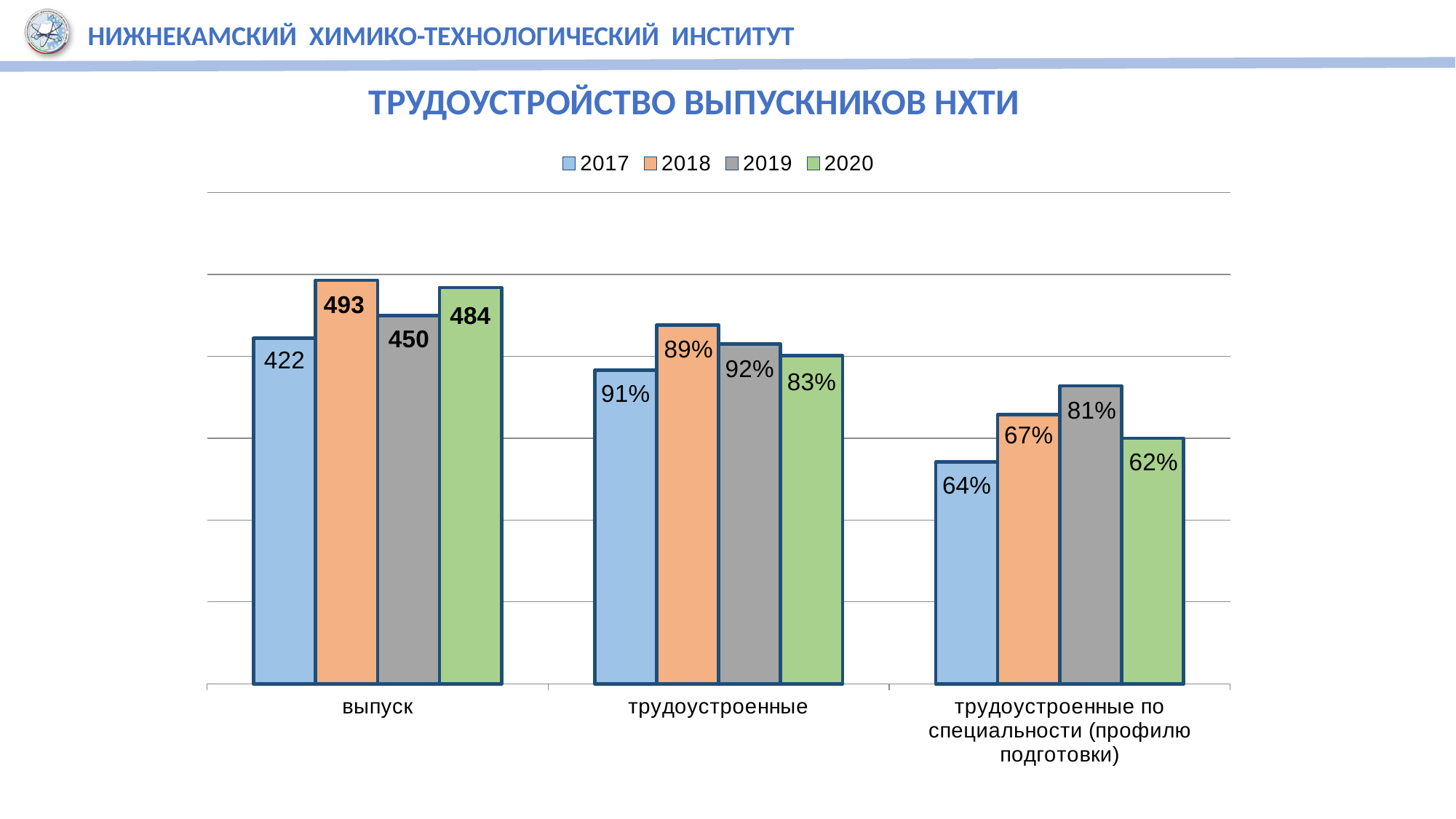
What kind of chart is shown on the slide? bar chart Which year has the lowest value in the 'выпуск' category? 2017 What is the value for 2017 in the 'трудоустроенные' category? 91% What is the difference between the 2018 and 2017 values in the 'выпуск' category? 71 What is the value for 2018 in the 'выпуск' category? 493 How many categories are shown on the x axis? 3 How many series does the legend list? 4 Which year has the highest value in the 'трудоустроенные по специальности (профилю подготовки)' category? 2019 Which year has the highest value in the 'выпуск' category? 2018 What is the value for 2020 in the 'трудоустроенные' category? 83% What is the title of the chart? ТРУДОУСТРОЙСТВО ВЫПУСКНИКОВ НХТИ What is the value for 2019 in the 'трудоустроенные по специальности (профилю подготовки)' category? 81%